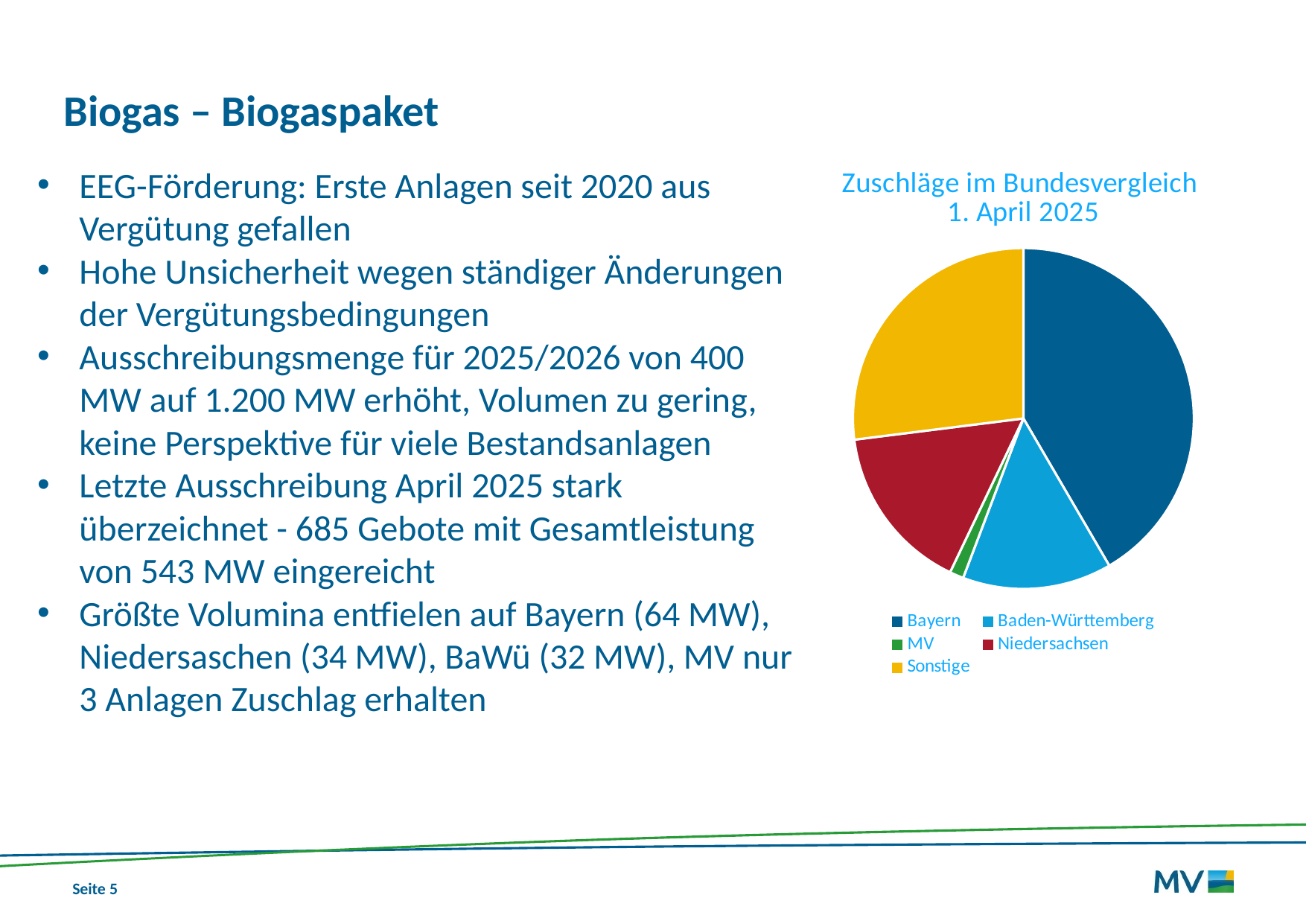
How many slices does the pie chart have? 5 Which slice is larger in the pie chart, Bayern or Baden-Württemberg? Bayern Which slice is larger in the pie chart, Bayern or Sonstige? Bayern What kind of chart is shown on the slide? pie chart Which slice is larger in the pie chart, Baden-Württemberg or MV? Baden-Württemberg Which category is shown in yellow in the pie chart? Sonstige Which category has the smallest slice in the pie chart? MV Which category has the largest slice in the pie chart? Bayern What is the title of the pie chart? Zuschläge im Bundesvergleich 1. April 2025 How many entries does the legend of the pie chart list? 5